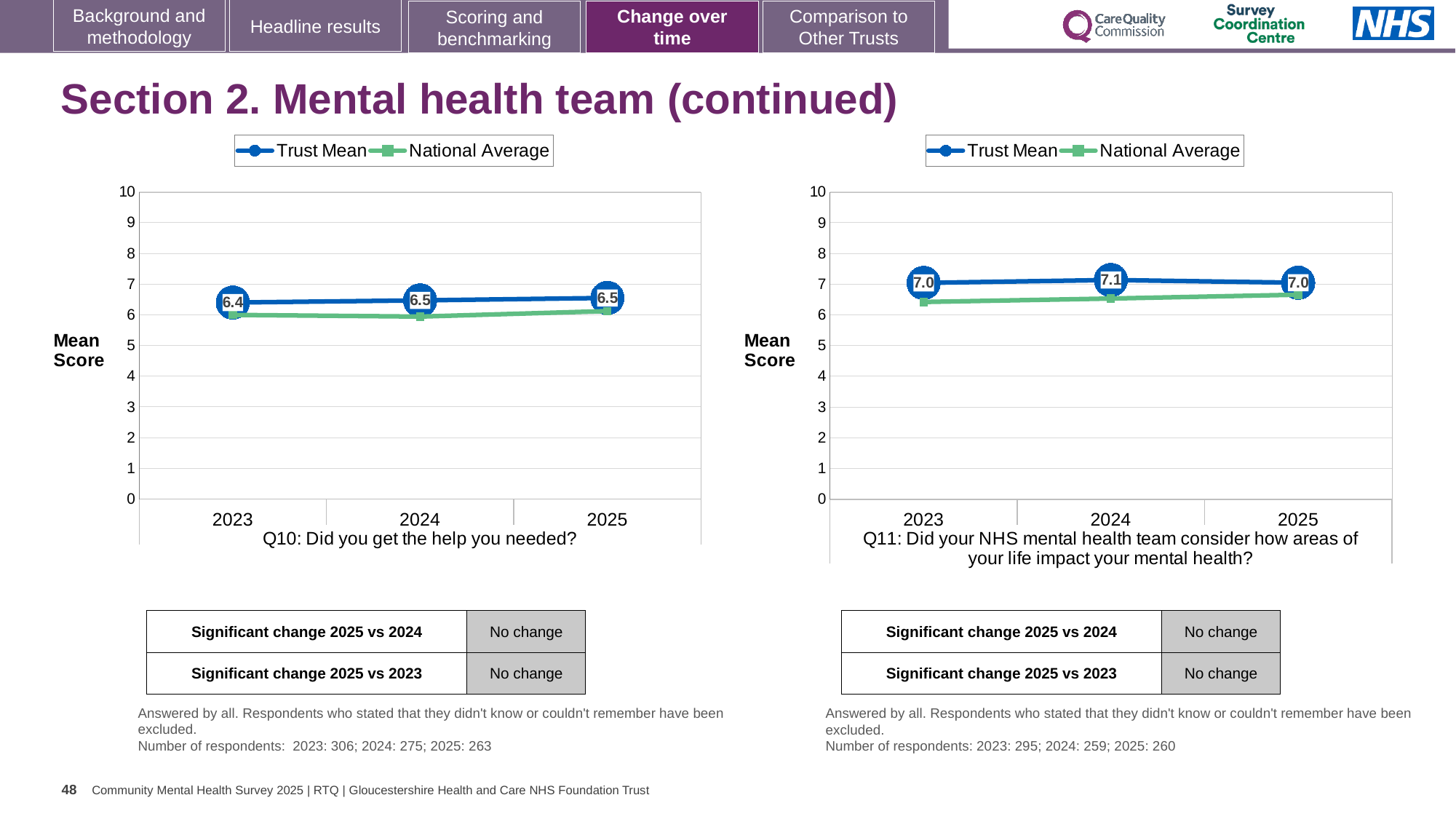
In the Q11 chart on the right, which year has the highest Trust Mean? 2024 In the Q10 chart on the left, which year has the lowest Trust Mean? 2023 How many years are shown on the x axis of the Q10 chart on the left? 3 In the Q11 chart on the right, is the National Average for 2023 greater or less than 7? less What kind of chart is the Q10 chart on the left? Line chart In the Q11 chart on the right, which is larger in 2023: the Trust Mean or the National Average? Trust Mean How many series does the legend of the Q11 chart on the right list? 2 In the Q11 chart on the right, what is the Trust Mean for 2025? 7.0 In the Q11 chart on the right, what is the Trust Mean for 2024? 7.1 In the Q10 chart on the left, what is the Trust Mean for 2024? 6.5 In the Q10 chart on the left, what is the difference between the Trust Mean for 2025 and for 2023? 0.1 In the Q10 chart on the left, what is the Trust Mean for 2023? 6.4